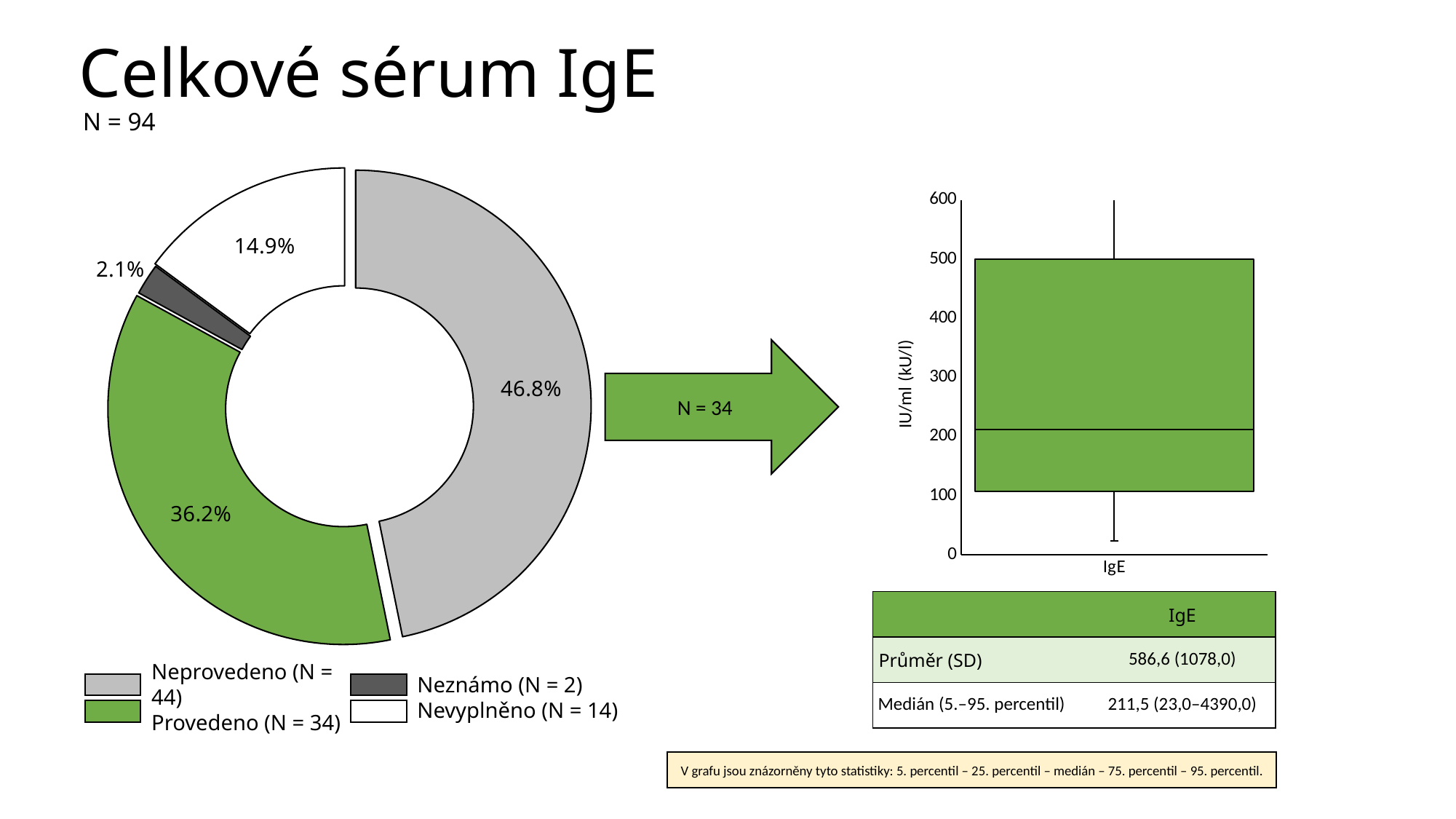
In the donut chart on the left, what percentage is shown for the Nevyplněno slice? 14.9% According to the legend of the donut chart on the left, how many cases (N) are in the Provedeno category? 34 How many categories does the legend of the donut chart on the left list? 4 In the donut chart on the left, which category has the smallest share? Neznámo In the box plot on the right, is the top edge of the box greater or less than 400? greater In the donut chart on the left, what is the difference in percentage points between the Neprovedeno and Provedeno slices? 10.6 In the donut chart on the left, which slice is larger: Nevyplněno or Neznámo? Nevyplněno In the donut chart on the left, what percentage is shown for the Neprovedeno slice? 46.8% In the donut chart on the left, what percentage is shown for the Neznámo slice? 2.1% In the donut chart on the left, what percentage is shown for the Provedeno slice? 36.2% What kind of chart is shown on the right side of the slide? Box plot In the donut chart on the left, which category has the largest share? Neprovedeno